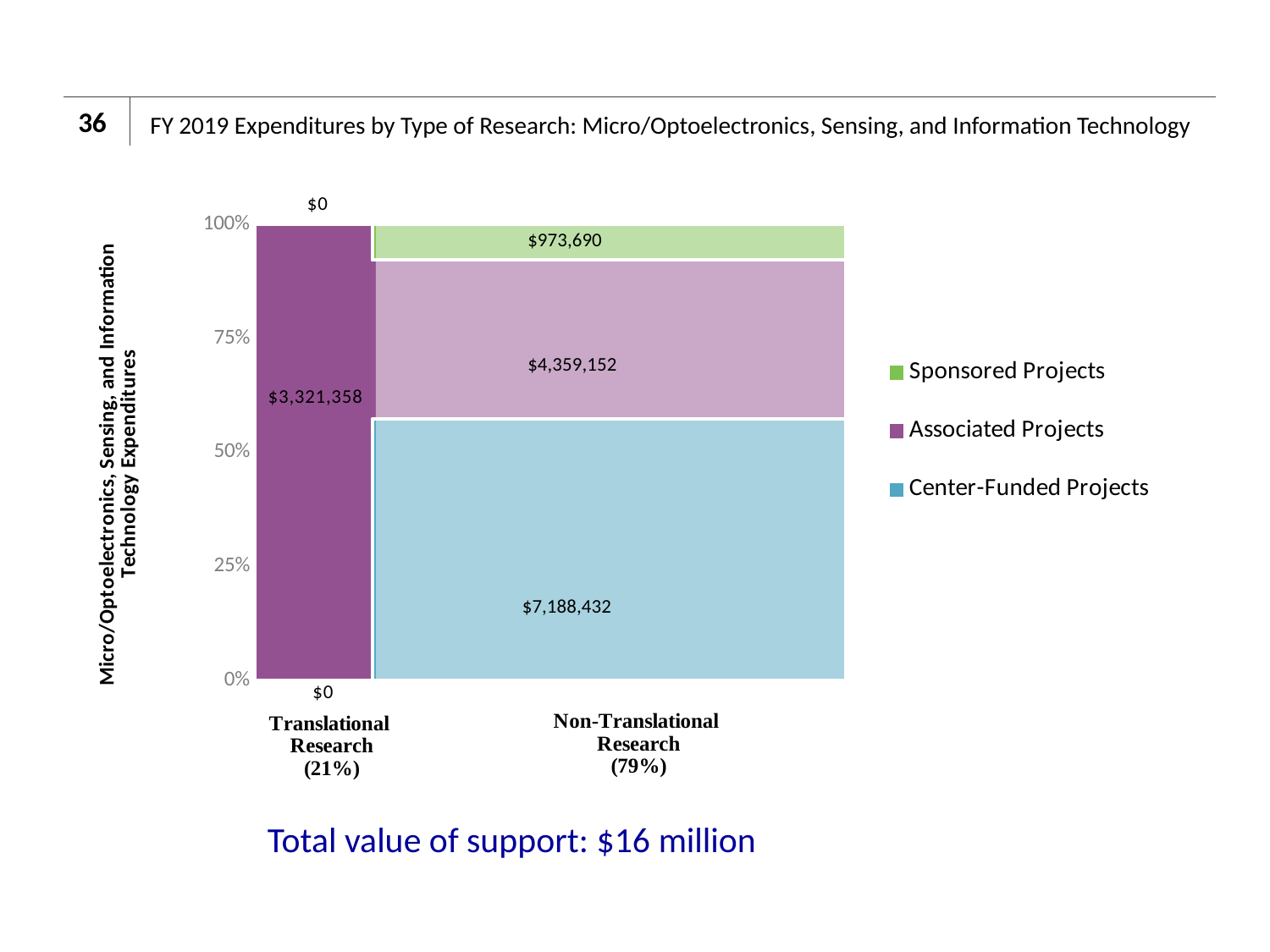
What is the difference between the Center-Funded Projects and Associated Projects values for Non-Translational Research? $2,829,280 Which series has the smallest value within the Non-Translational Research bar? Sponsored Projects Which is larger: Associated Projects for Non-Translational Research or Associated Projects for Translational Research? Associated Projects for Non-Translational Research How many series does the legend list? 3 Which series has the largest value within the Non-Translational Research bar? Center-Funded Projects What is the Associated Projects value for Non-Translational Research? $4,359,152 What is the Associated Projects value for Translational Research? $3,321,358 What is the Sponsored Projects value for Non-Translational Research? $973,690 What is the total of the Non-Translational Research bar? $12,521,274 What kind of chart is shown on the slide? Stacked bar chart What is the Sponsored Projects value for Translational Research? $0 What is the Center-Funded Projects value for Non-Translational Research? $7,188,432